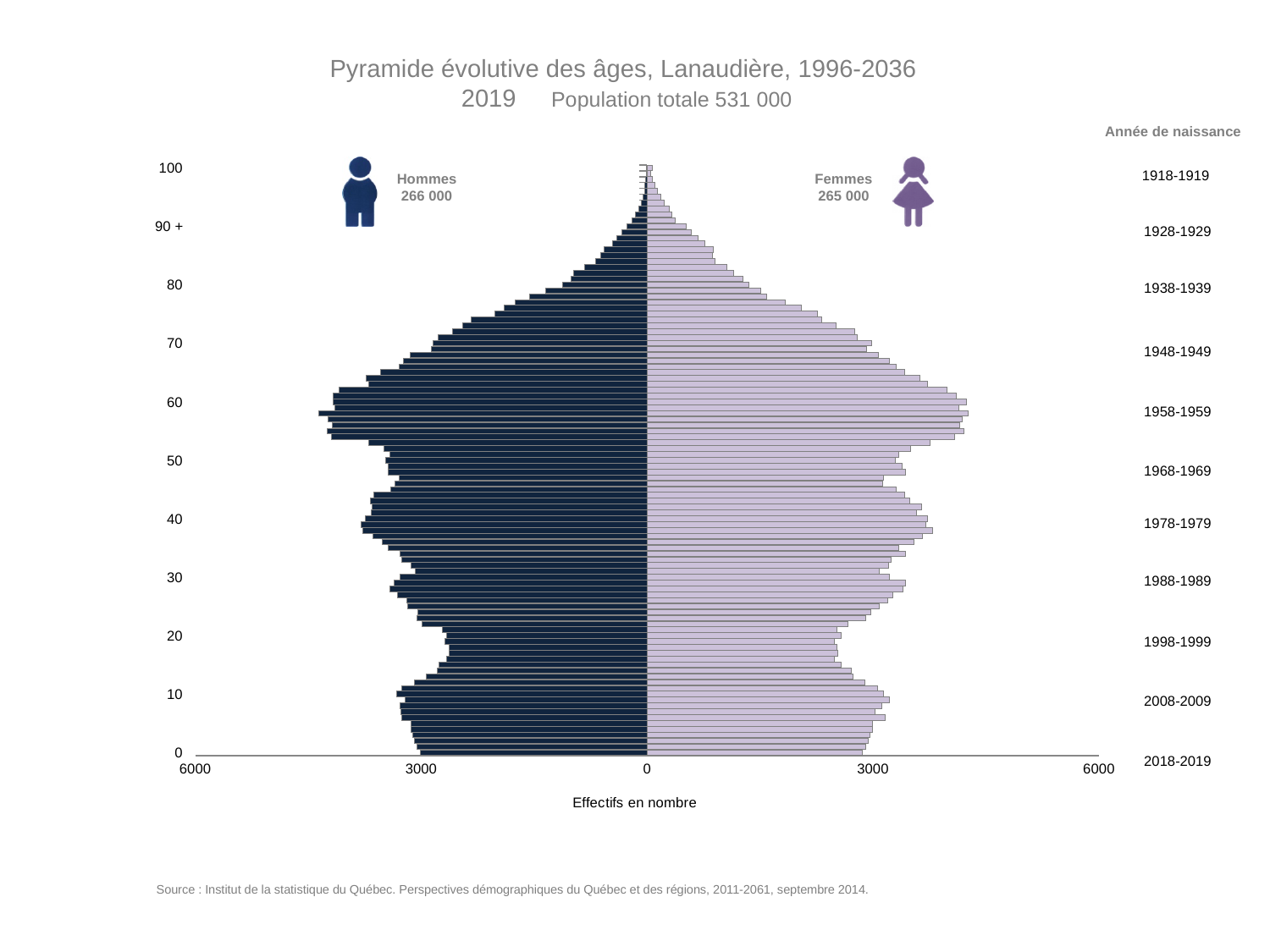
Is the value for Hommes at around age 58 greater or less than 3000? greater What is the total population shown for 2019? 531 000 What is the title of the chart? Pyramide évolutive des âges, Lanaudière, 1996-2036 What is the number of Hommes shown on the chart? 266 000 Which group is larger, Hommes or Femmes? Hommes What kind of chart is shown on the slide? Bar chart (population pyramid) Is the value for Hommes at around age 80 greater or less than 3000? less What is the number of Femmes shown on the chart? 265 000 What is the difference between the number of Hommes and the number of Femmes? 1 000 Do the bar lengths rise or fall as age increases from 60 to 100? fall Is the value for Femmes at around age 20 greater or less than 3000? less How many series (sexes) does the chart show? 2